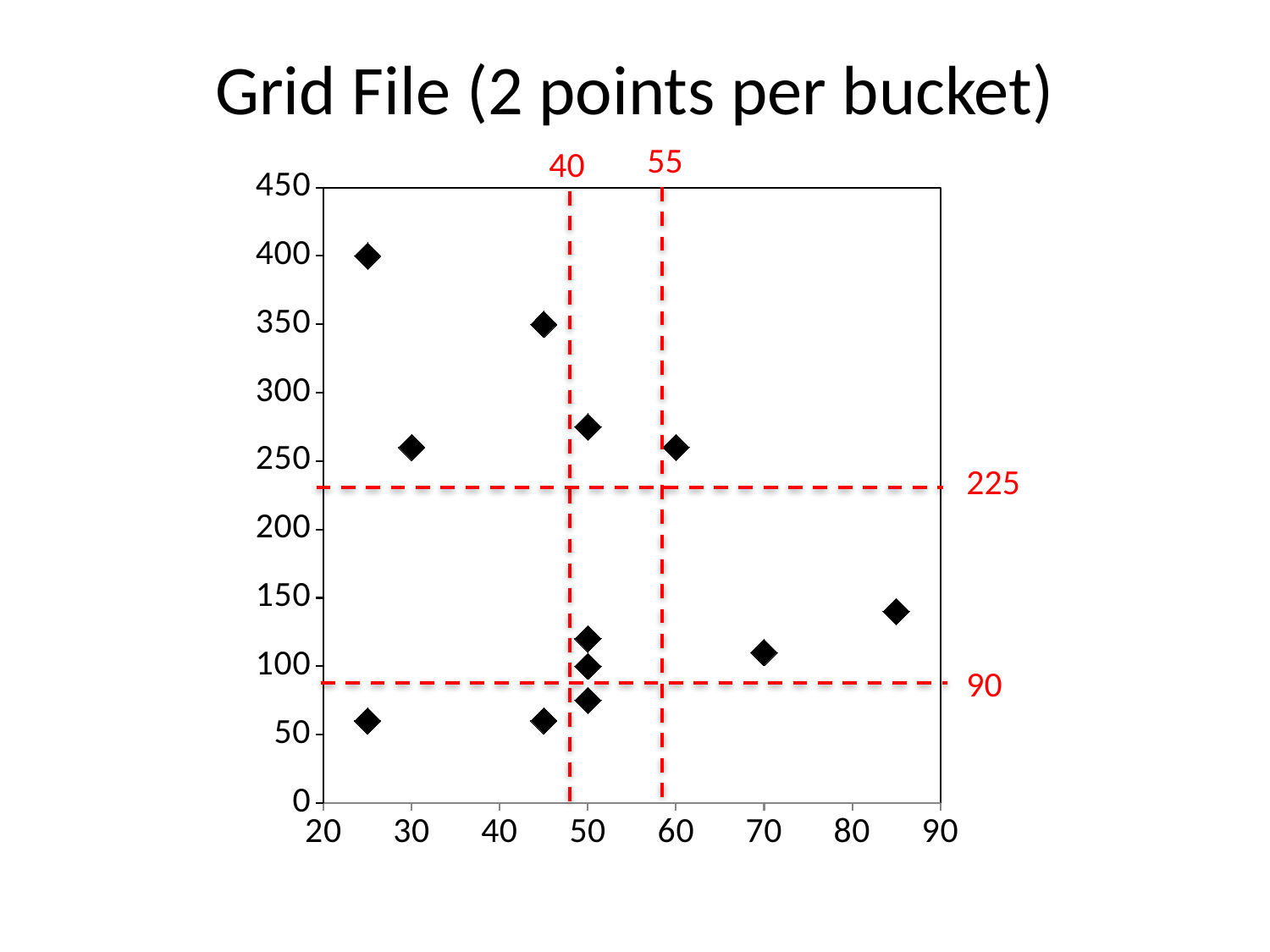
How many points lie above the horizontal dashed line labelled 225? 5 What is the title of the chart? Grid File (2 points per bucket) What kind of chart is shown on the slide? Scatter plot What is the y-value of the highest plotted point? 400 What is the x-value of the point with the highest y-value: greater or less than 30? less How many data points are plotted on the chart? 12 What are the labels on the two vertical red dashed lines? 40 and 55 Is the y-value of the point near x = 70 greater or less than 150? less Is the y-value of the rightmost point (near x = 85) greater or less than 100? greater How many points lie to the right of the vertical dashed line labelled 55? 3